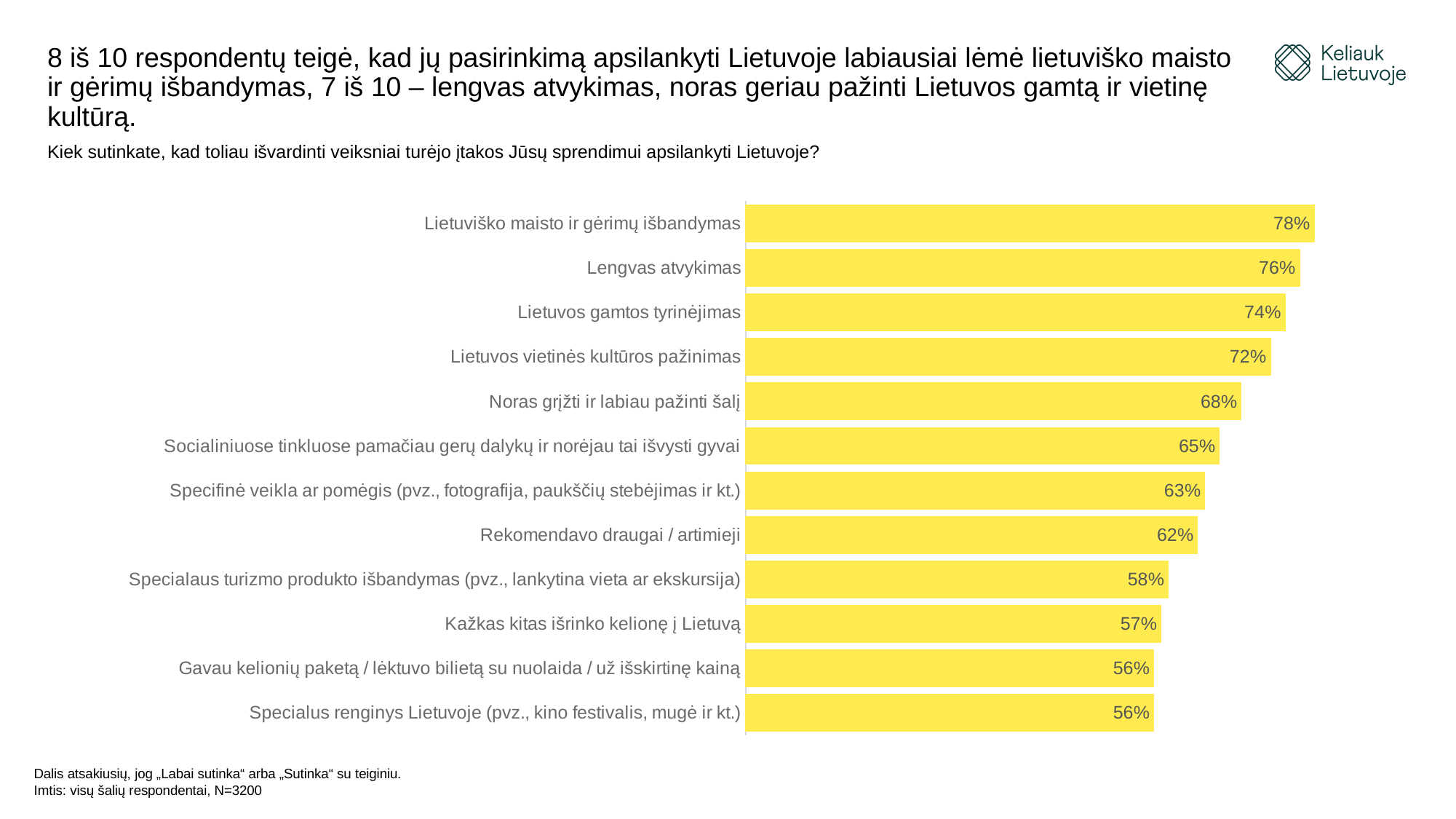
What is the value for "Lengvas atvykimas"? 76% What is the difference between "Noras grįžti ir labiau pažinti šalį" and "Specialaus turizmo produkto išbandymas (pvz., lankytina vieta ar ekskursija)"? 10% Which is larger: "Lietuvos gamtos tyrinėjimas" or "Socialiniuose tinkluose pamačiau gerų dalykų ir norėjau tai išvysti gyvai"? Lietuvos gamtos tyrinėjimas What is the value for "Rekomendavo draugai / artimieji"? 62% Which category has the highest value? Lietuviško maisto ir gėrimų išbandymas What is the difference between "Lietuviško maisto ir gėrimų išbandymas" and "Lietuvos vietinės kultūros pažinimas"? 6% What is the value for "Kažkas kitas išrinko kelionę į Lietuvą"? 57% What is the sample size (N) stated at the bottom of the slide? N=3200 What kind of chart is shown on the slide? Bar chart What is the lowest value shown in the chart? 56% How many categories are shown in the chart? 12 What is the value for "Lietuviško maisto ir gėrimų išbandymas"? 78%